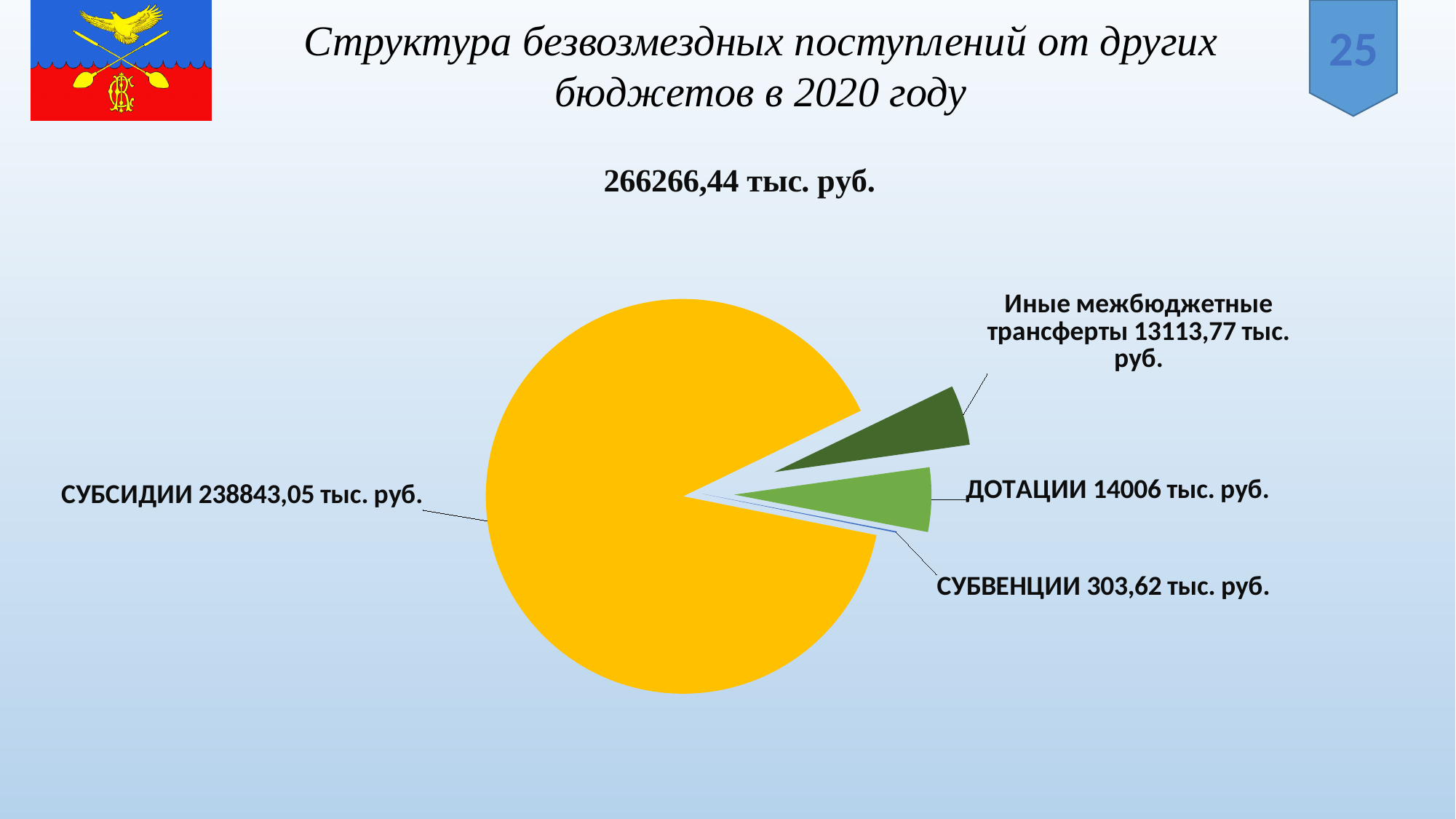
What is the value for ДОТАЦИИ? 14006 тыс. руб. What colour is the СУБСИДИИ slice? yellow What is the value for СУБВЕНЦИИ? 303,62 тыс. руб. Which category has the smallest slice of the pie? СУБВЕНЦИИ What is the difference between ДОТАЦИИ and Иные межбюджетные трансферты? 892,23 тыс. руб. How many slices does the pie chart have? 4 What is the value for СУБСИДИИ? 238843,05 тыс. руб. What total amount is shown above the pie chart? 266266,44 тыс. руб. What is the value for Иные межбюджетные трансферты? 13113,77 тыс. руб. Which is larger, ДОТАЦИИ or Иные межбюджетные трансферты? ДОТАЦИИ Which category has the largest slice of the pie? СУБСИДИИ What kind of chart is shown on the slide? pie chart